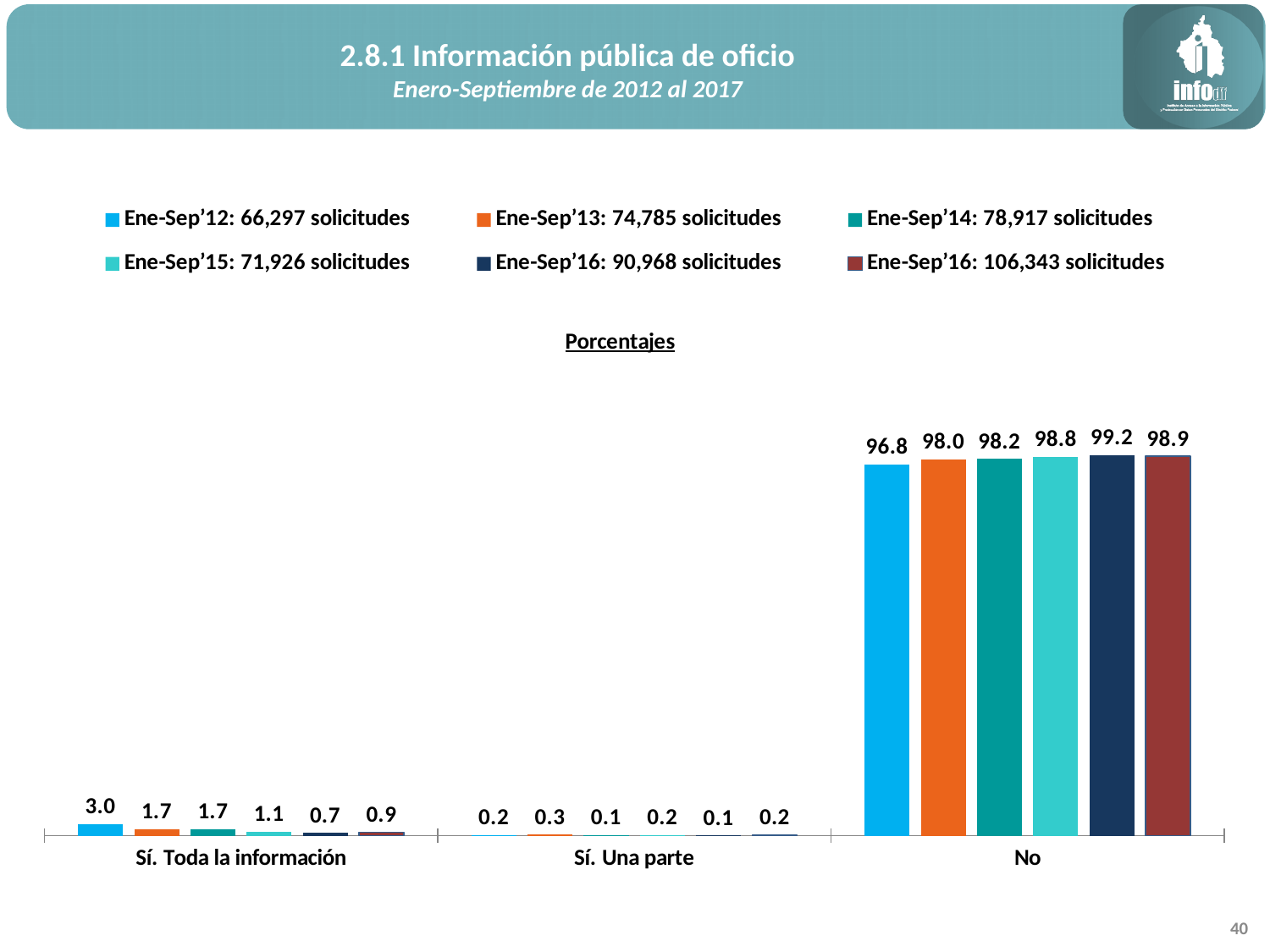
What is the underlined heading shown above the chart? Porcentajes What is the value for Ene-Sep'15 (71,926 solicitudes) in the 'Sí. Toda la información' category? 1.1 What is the difference between the Ene-Sep'12 (66,297 solicitudes) value and the Ene-Sep'16 (90,968 solicitudes) value in the 'No' category? 2.4 What is the difference between the Ene-Sep'12 value and the Ene-Sep'15 value in the 'Sí. Toda la información' category? 1.9 What is the value for Ene-Sep'13 (74,785 solicitudes) in the 'Sí. Una parte' category? 0.3 How many series does the legend list? 6 What kind of chart is shown on the slide? bar chart Which series has the highest value in the 'No' category? Ene-Sep'16: 90,968 solicitudes What is the value for Ene-Sep'12 (66,297 solicitudes) in the 'No' category? 96.8 How many categories are shown on the x axis? 3 In the 'Sí. Toda la información' category, which is larger: the value for Ene-Sep'12 (66,297 solicitudes) or the value for Ene-Sep'13 (74,785 solicitudes)? Ene-Sep'12: 66,297 solicitudes Which series has the lowest value in the 'Sí. Toda la información' category? Ene-Sep'16: 90,968 solicitudes